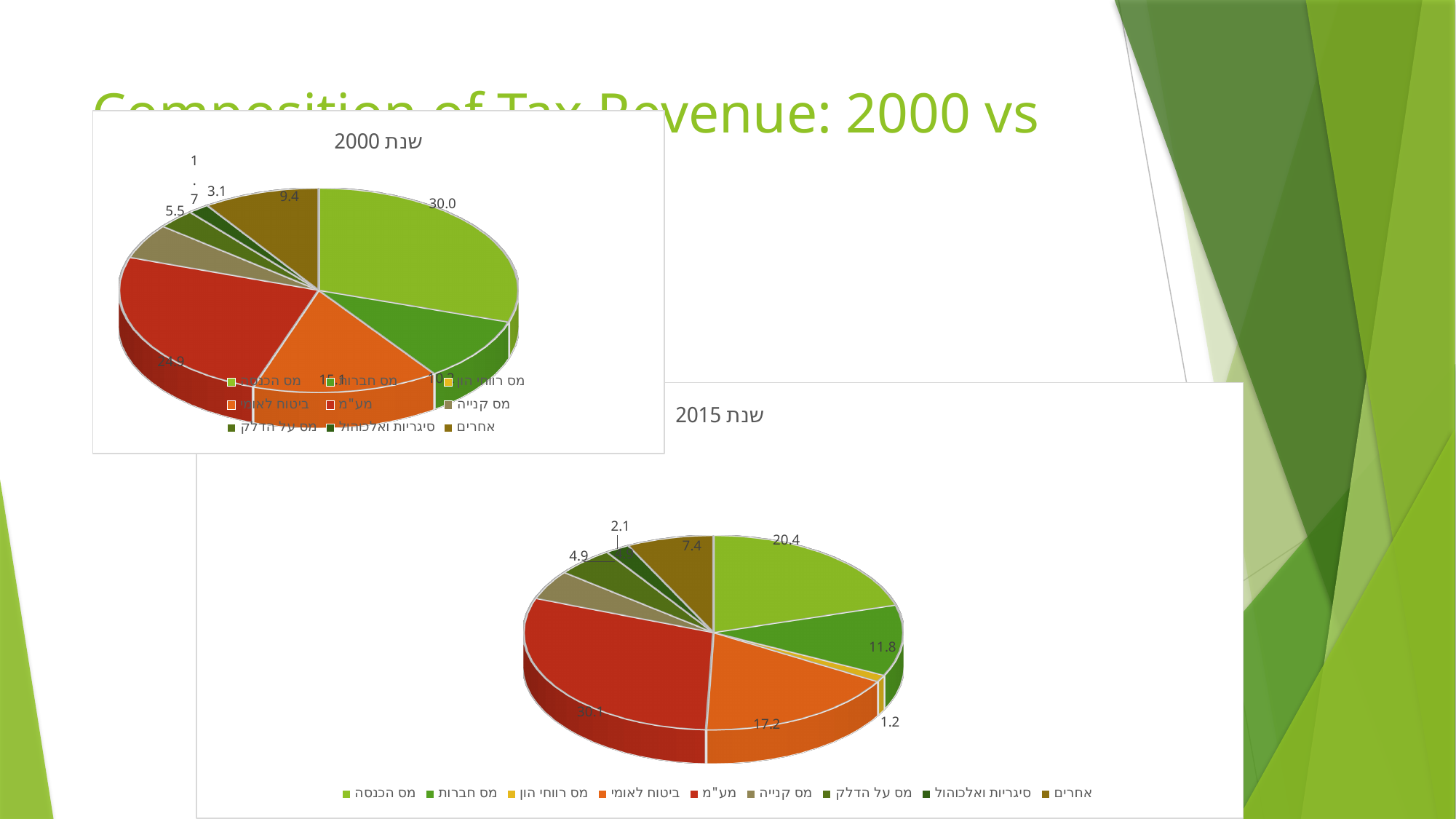
In the 2015 chart (שנת 2015), which category has the largest slice? מע"מ How many categories does the legend of the 2015 chart (שנת 2015) list? 9 What kind of chart is the 2015 chart (שנת 2015)? Pie chart In the 2000 chart (שנת 2000), what is the value for מס הכנסה? 30.0 In the 2015 chart (שנת 2015), which category has the smallest slice? מס רווחי הון In the 2015 chart (שנת 2015), what is the value for מס חברות? 11.8 Which is larger: the value for מס הכנסה in the 2000 chart or in the 2015 chart? 2000 chart In the 2015 chart (שנת 2015), what is the difference between the values for מע"מ and מס הכנסה? 9.7 In the 2015 chart (שנת 2015), what is the value for ביטוח לאומי? 17.2 In the 2015 chart (שנת 2015), what is the value for מע"מ? 30.1 In the 2000 chart (שנת 2000), what is the value for אחרים? 9.4 In the 2015 chart (שנת 2015), what is the value for מס הכנסה? 20.4